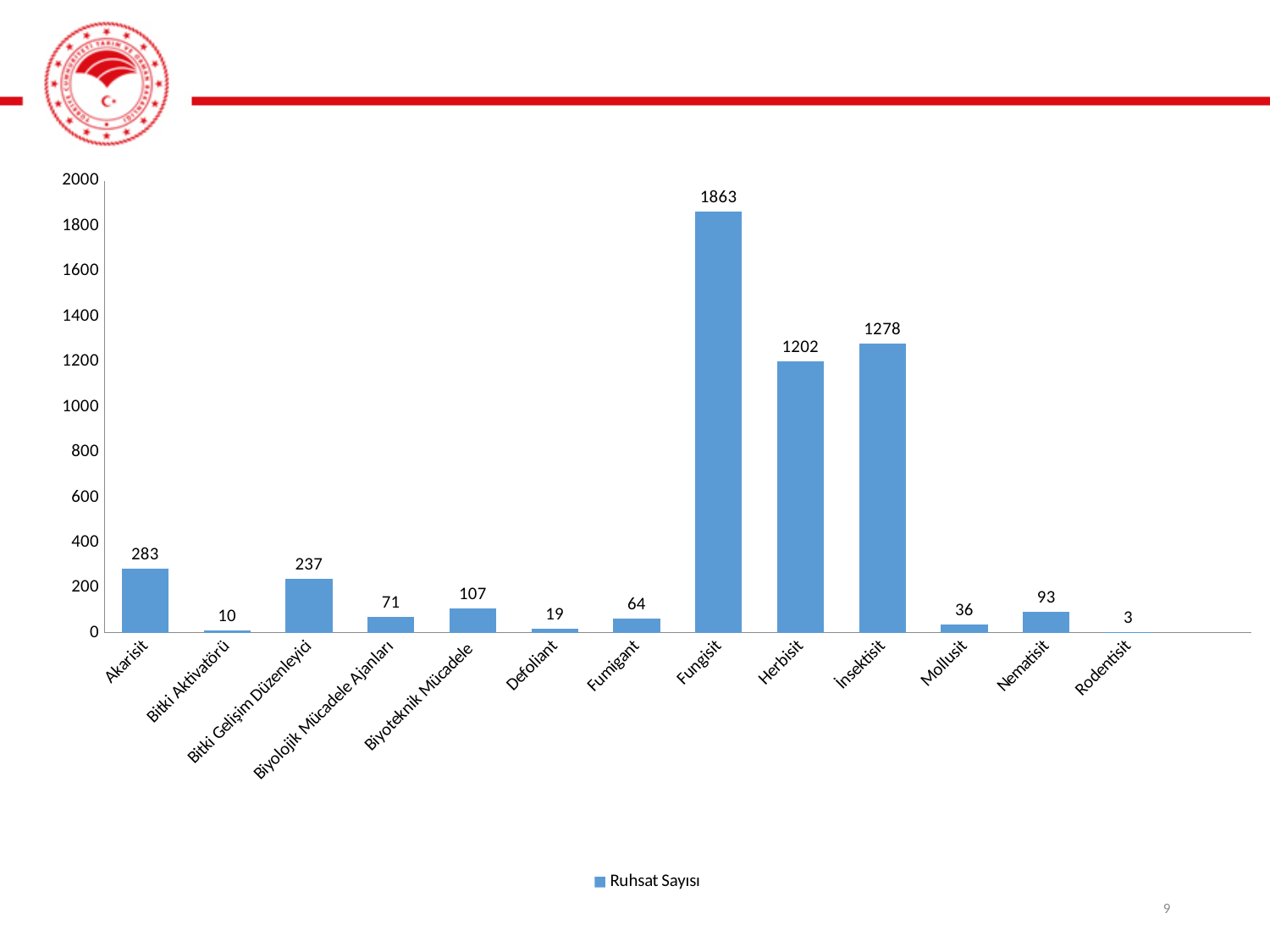
What is the value for Fungisit? 1863 Which is larger, the value for Biyoteknik Mücadele or the value for Fumigant? Biyoteknik Mücadele How many categories are shown on the x axis? 13 What is the value for Nematisit? 93 What kind of chart is shown on the slide? Bar chart Which category has the lowest value? Rodentisit What is the difference between the values for Fungisit and Herbisit? 661 Which category has the highest value? Fungisit Which is larger, the value for İnsektisit or the value for Herbisit? İnsektisit What is the value for Bitki Gelişim Düzenleyici? 237 How many series does the legend list? 1 What is the difference between the values for Akarisit and Bitki Gelişim Düzenleyici? 46